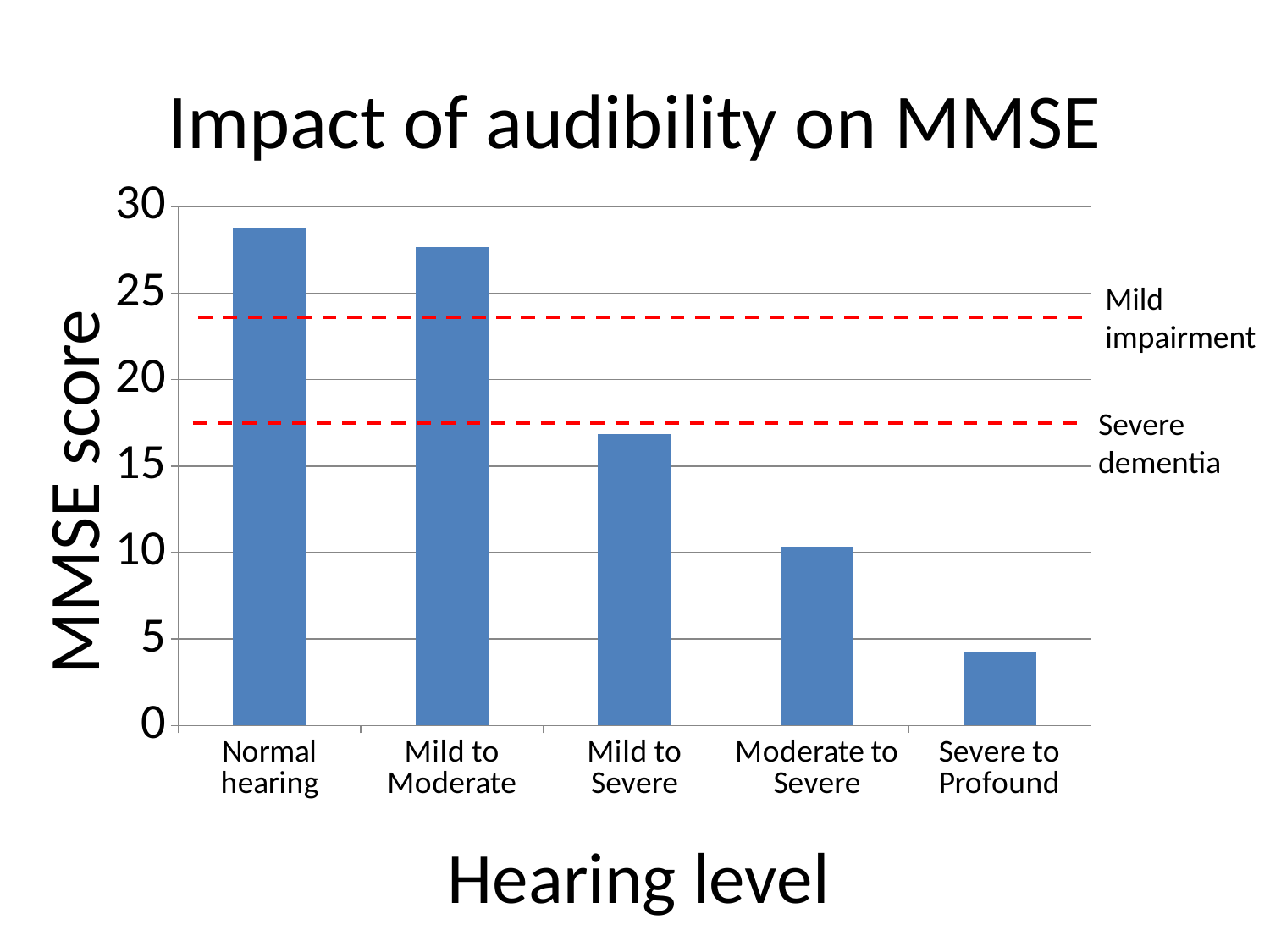
Is the MMSE score for Severe to Profound greater or less than 5? less Which has a higher MMSE score, Mild to Moderate or Mild to Severe? Mild to Moderate What is the label of the y axis? MMSE score Is the MMSE score for Normal hearing greater or less than 25? greater Which hearing level has the lowest MMSE score? Severe to Profound Do the MMSE scores rise or fall as hearing level moves from Normal hearing to Severe to Profound? fall What kind of chart is shown on the slide? bar chart What is the title of the chart? Impact of audibility on MMSE Which hearing level has the highest MMSE score? Normal hearing How many hearing level categories are plotted on the chart? 5 Is the MMSE score for Mild to Severe greater or less than 20? less